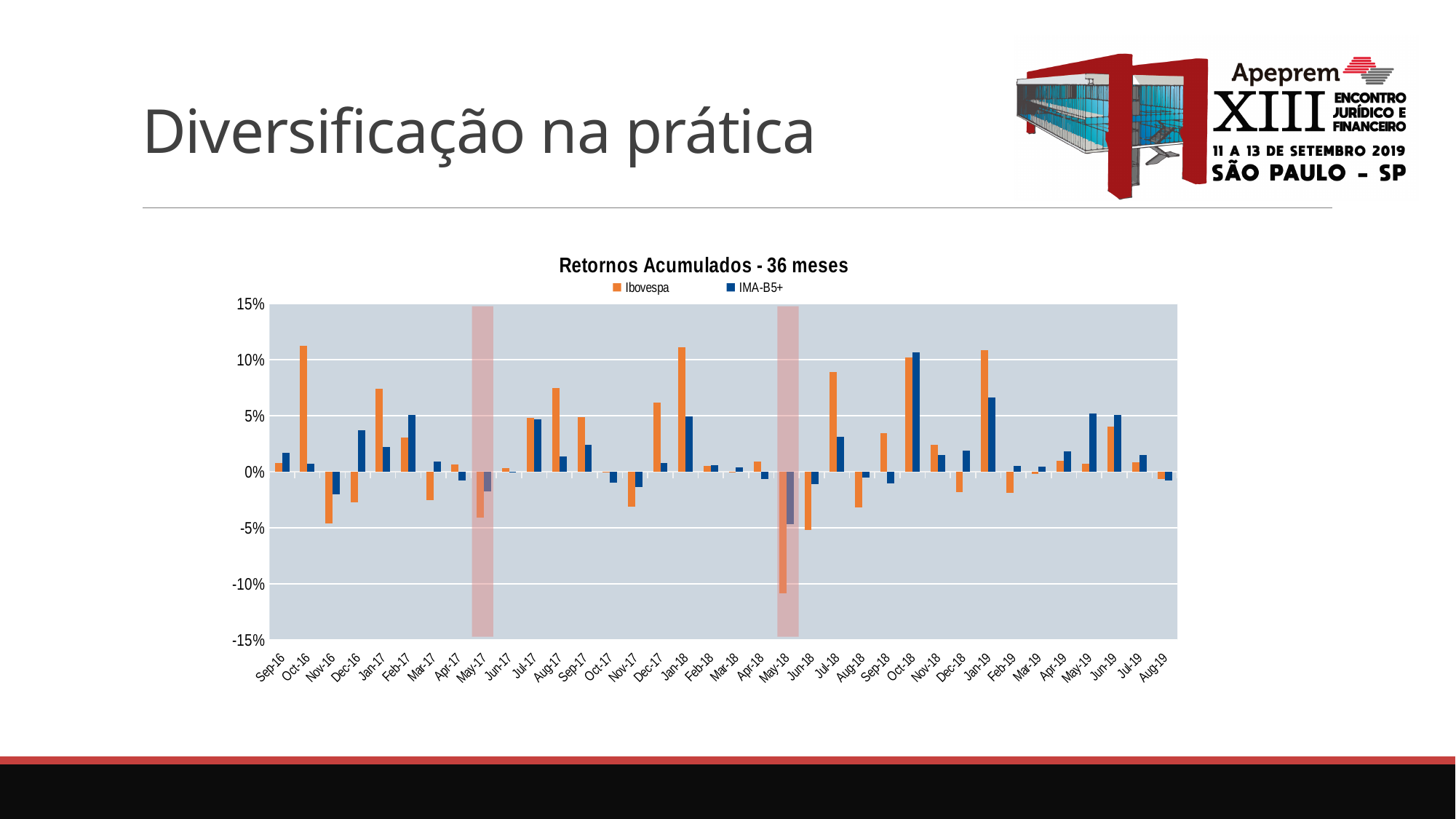
In which month does the IMA-B5+ series reach its highest value? Oct-18 How many months are shown along the x axis of the chart? 36 In which month does the Ibovespa series reach its lowest value? May-18 In Jan-19, which series has the larger value, Ibovespa or IMA-B5+? Ibovespa How many series does the chart's legend list? 2 What is the title of the chart? Retornos Acumulados - 36 meses What kind of chart is shown on the slide? Bar chart Is the Ibovespa value for Jul-18 greater or less than 5%? greater Is the Ibovespa value for May-18 greater or less than -10%? less Is the Ibovespa value for Oct-16 greater or less than 10%? greater Which series is shown in orange in the chart? Ibovespa In which month does the IMA-B5+ series reach its lowest value? May-18